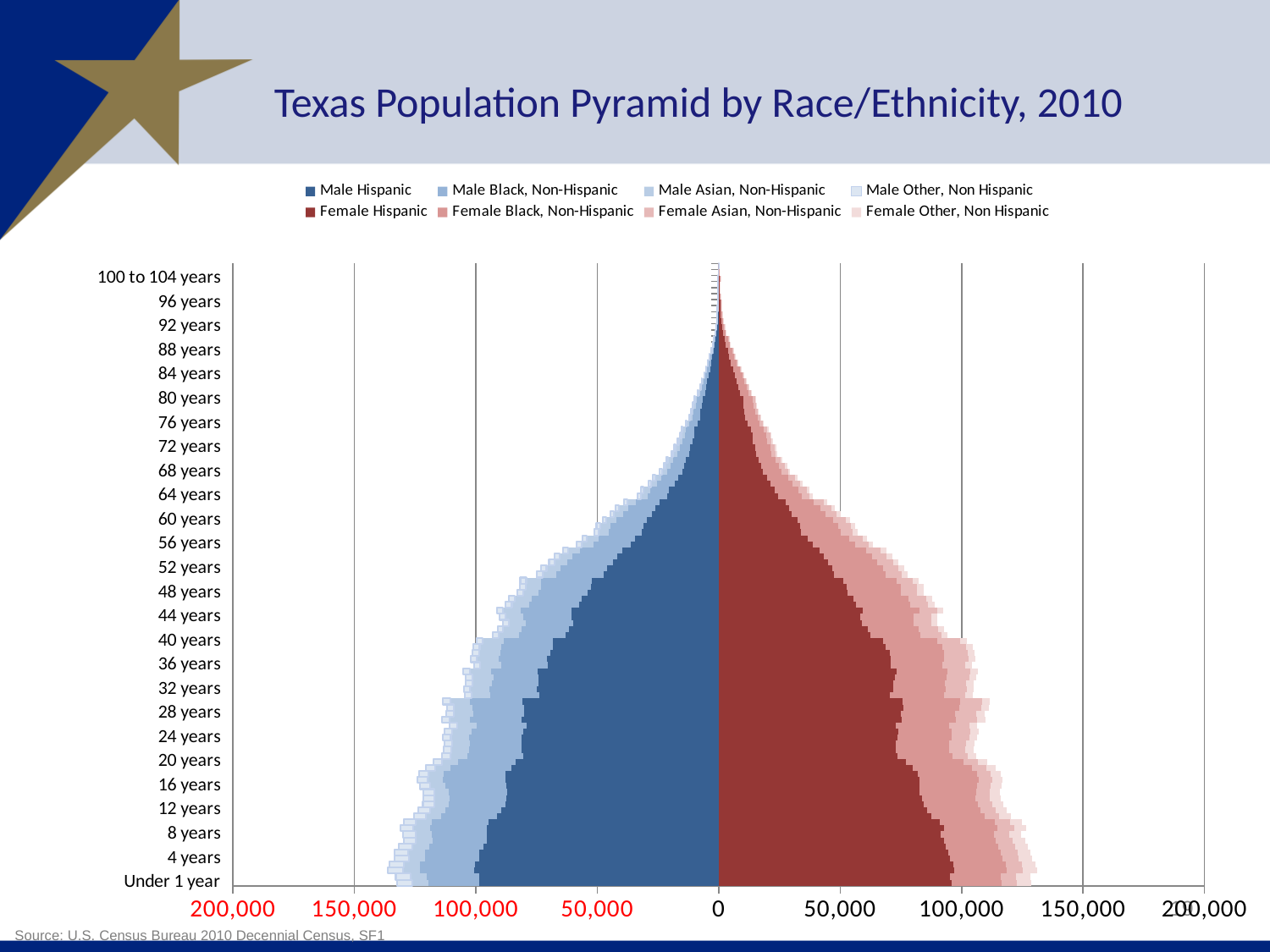
Is the total male population for Under 1 year greater or less than 100,000? greater Is the Male Hispanic value for 36 years greater or less than 100,000? less Is the total female population for 80 years greater or less than 50,000? less What kind of chart is shown on the slide? Bar chart (population pyramid) What is the title of the chart? Texas Population Pyramid by Race/Ethnicity, 2010 Which legend entry is shown in dark blue? Male Hispanic Do the bars generally get longer or shorter as age increases from Under 1 year to 100 to 104 years? shorter Which age group has the smallest total population, Under 1 year or 100 to 104 years? 100 to 104 years How many series does the legend list? 8